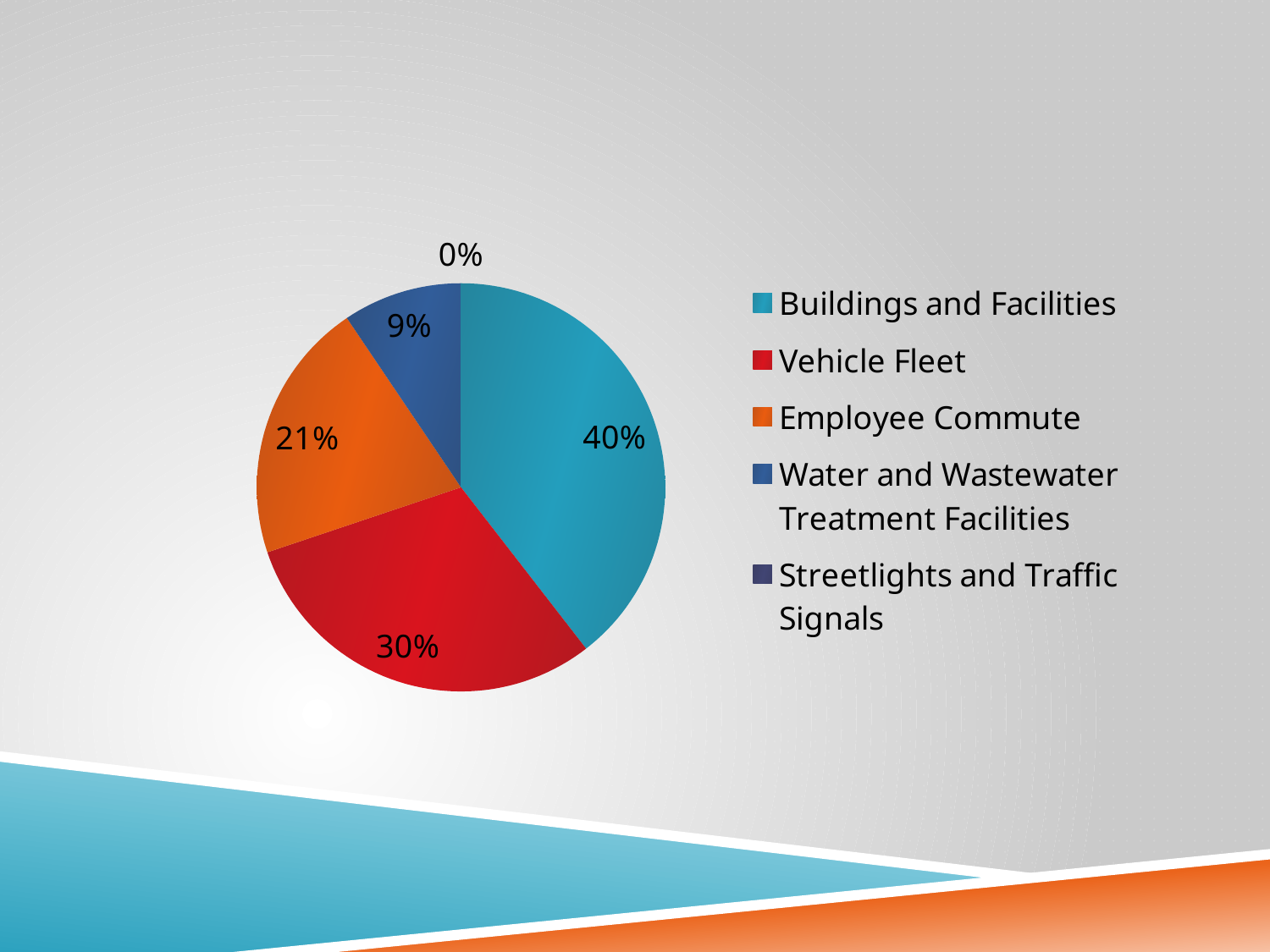
What share of the pie does Streetlights and Traffic Signals represent? 0% What colour is the Vehicle Fleet slice? red How many categories does the legend list? 5 What share of the pie does Buildings and Facilities represent? 40% What kind of chart is shown on the slide? pie chart Which is larger, the Employee Commute slice or the Water and Wastewater Treatment Facilities slice? Employee Commute Which category has the largest slice of the pie? Buildings and Facilities What is the difference in percentage points between Buildings and Facilities and Vehicle Fleet? 10 What share of the pie does Vehicle Fleet represent? 30% What share of the pie does Employee Commute represent? 21% Which category has the smallest slice of the pie? Streetlights and Traffic Signals What share of the pie does Water and Wastewater Treatment Facilities represent? 9%